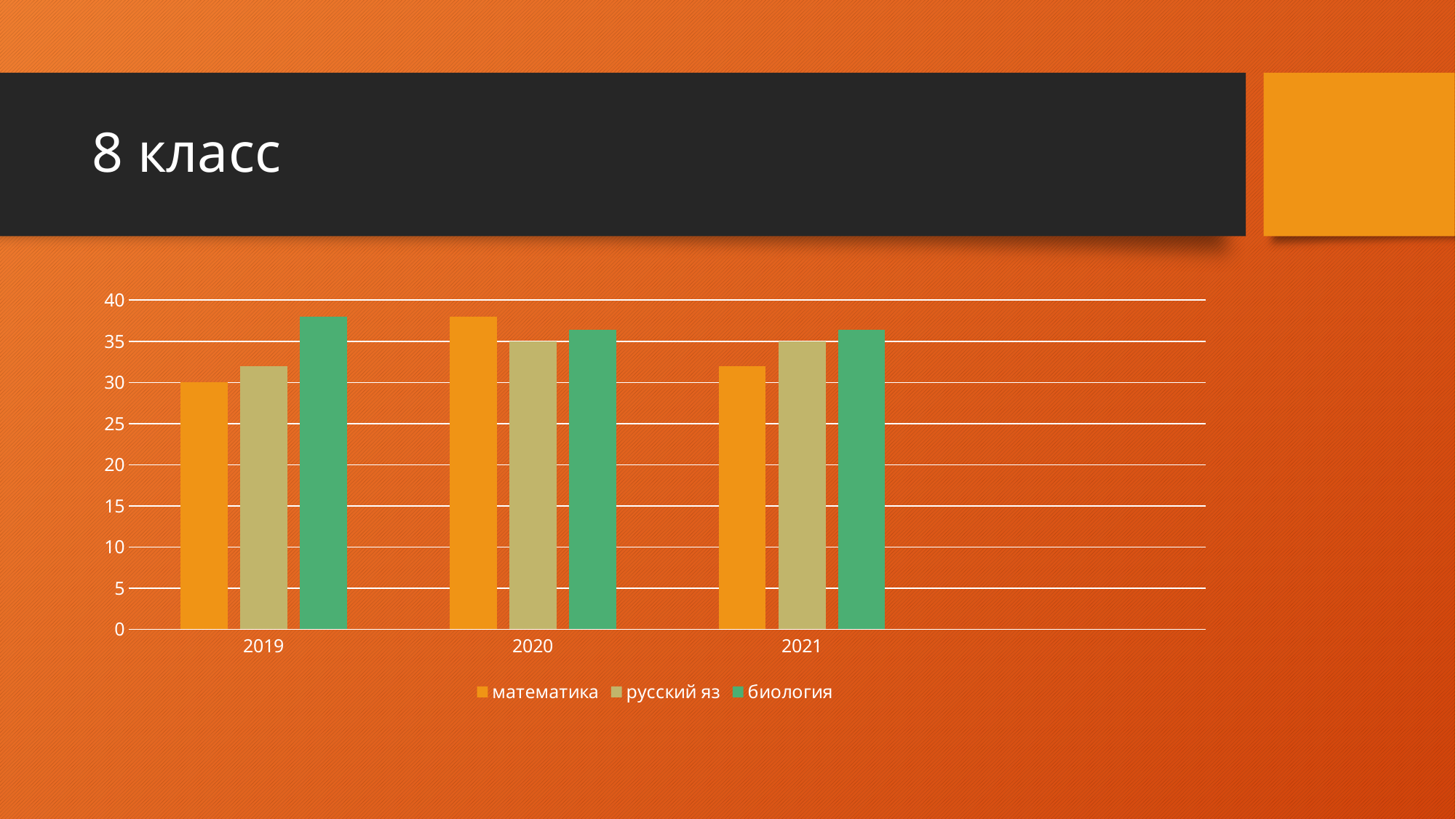
What is the value for математика in 2019? 30 Is the value for биология in 2019 greater or less than 35? greater What is the title of the slide? 8 класс How many year categories are shown on the x axis? 3 Is the value for русский яз in 2019 greater or less than 30? greater Which year has the highest value for математика? 2020 How many series does the legend list? 3 Is the value for математика in 2021 greater or less than 35? less What kind of chart is shown on the slide? bar chart Which year has the lowest value for математика? 2019 Which is larger in 2021, математика or биология? биология What is the value for русский яз in 2020? 35